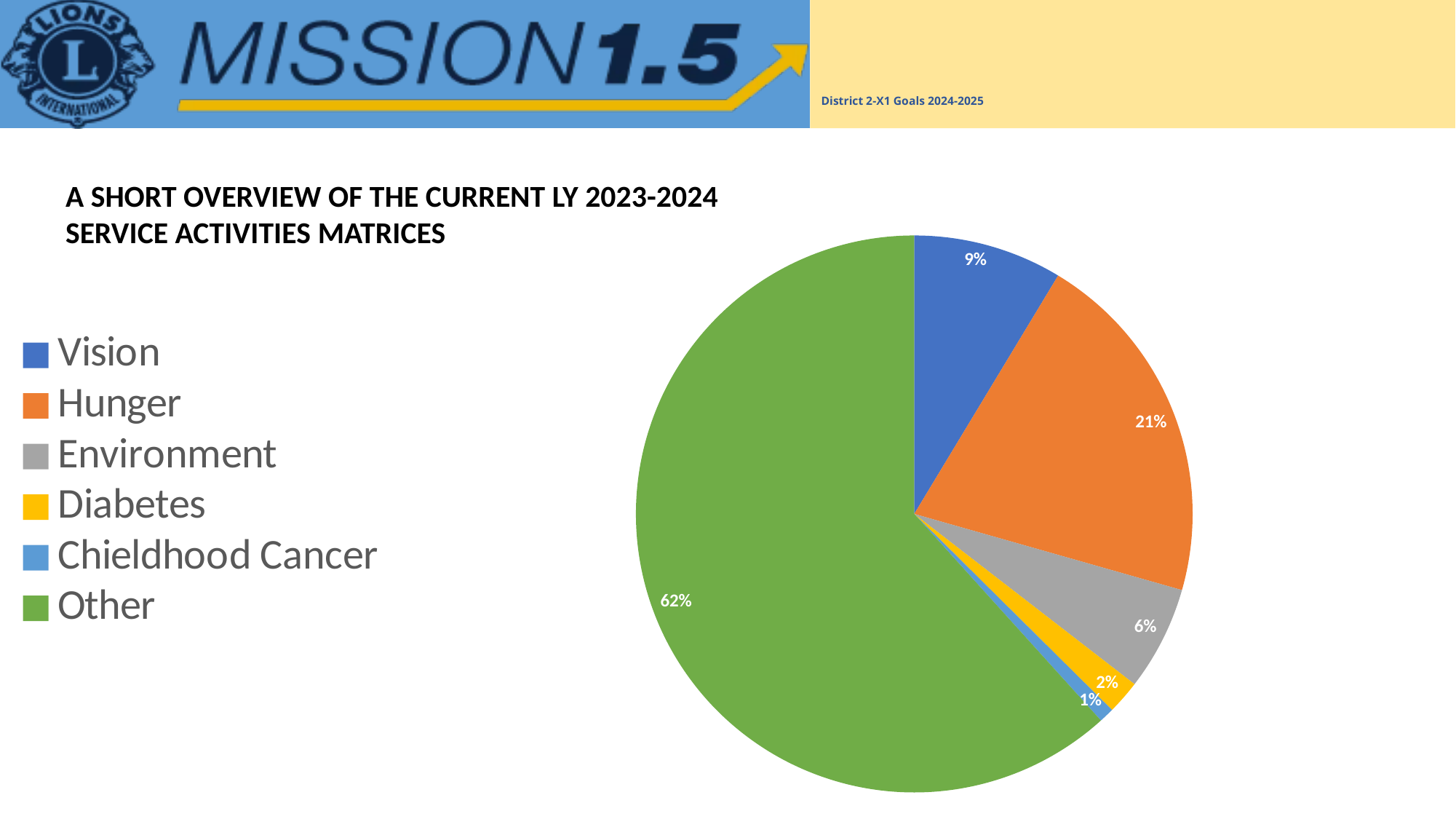
What percentage of the pie does Chieldhood Cancer account for? 1% What percentage of the pie does Other account for? 62% How many categories does the legend list? 6 What percentage of the pie does Environment account for? 6% What percentage of the pie does Vision account for? 9% What percentage of the pie does Hunger account for? 21% Which category has the smallest slice of the pie? Chieldhood Cancer What is the difference in percentage points between Hunger and Vision? 12 What kind of chart is shown on the slide? pie chart Which category has the largest slice of the pie? Other What percentage of the pie does Diabetes account for? 2% Which is larger, the Environment slice or the Diabetes slice? Environment